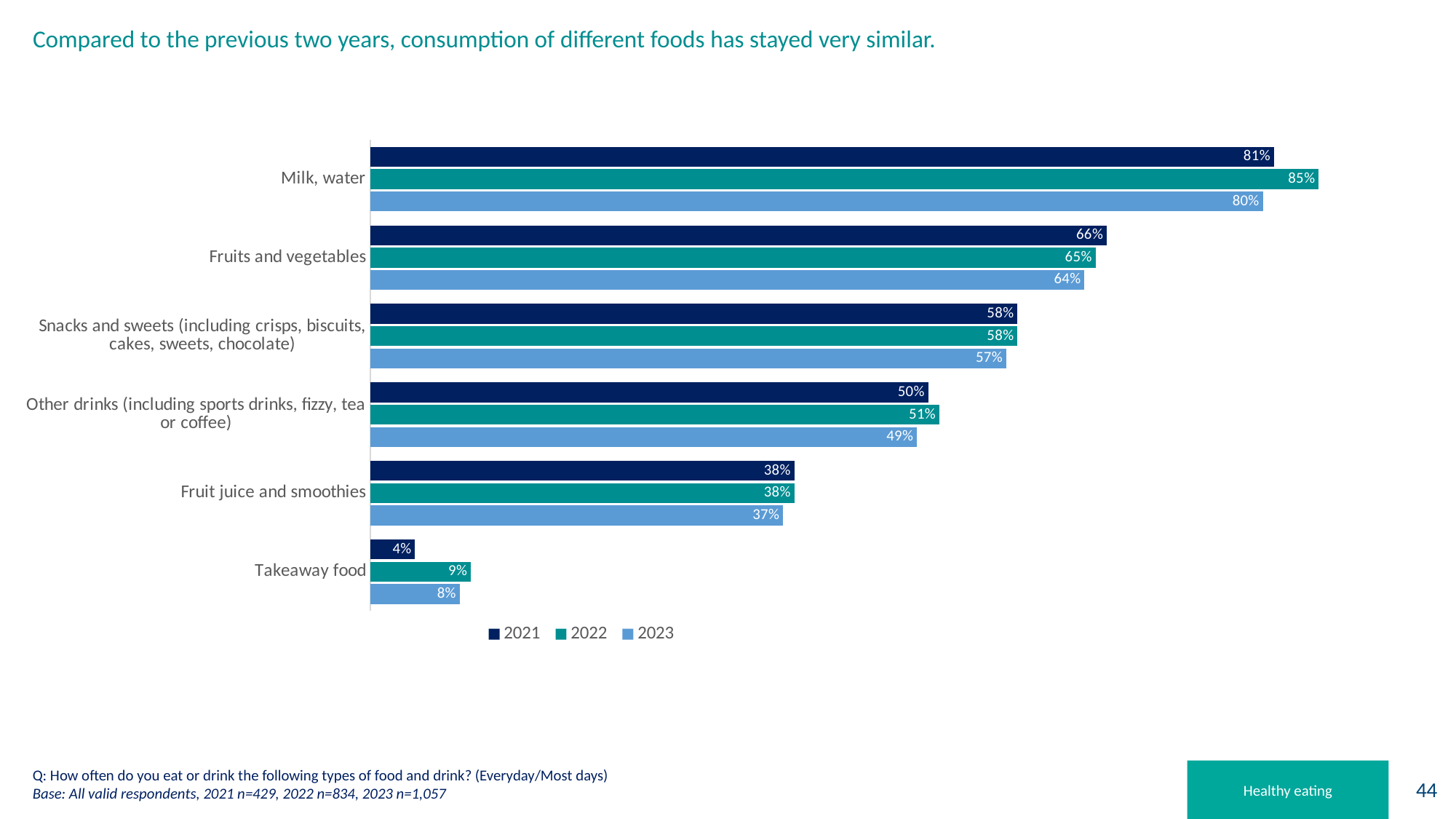
What is the 2023 value for Fruits and vegetables? 64% How many series does the legend list? 3 What is the difference between the 2022 and 2021 values for Takeaway food? 5% What kind of chart is shown on the slide? Bar chart Which is larger for Fruit juice and smoothies: the 2021 value or the 2023 value? 2021 What is the 2023 value for Other drinks (including sports drinks, fizzy, tea or coffee)? 49% What is the 2022 value for Milk, water? 85% How many food categories are shown on the chart? 6 What is the difference between the 2022 and 2023 values for Milk, water? 5% Which category has the highest 2023 value? Milk, water Which category has the lowest 2021 value? Takeaway food What is the 2021 value for Takeaway food? 4%